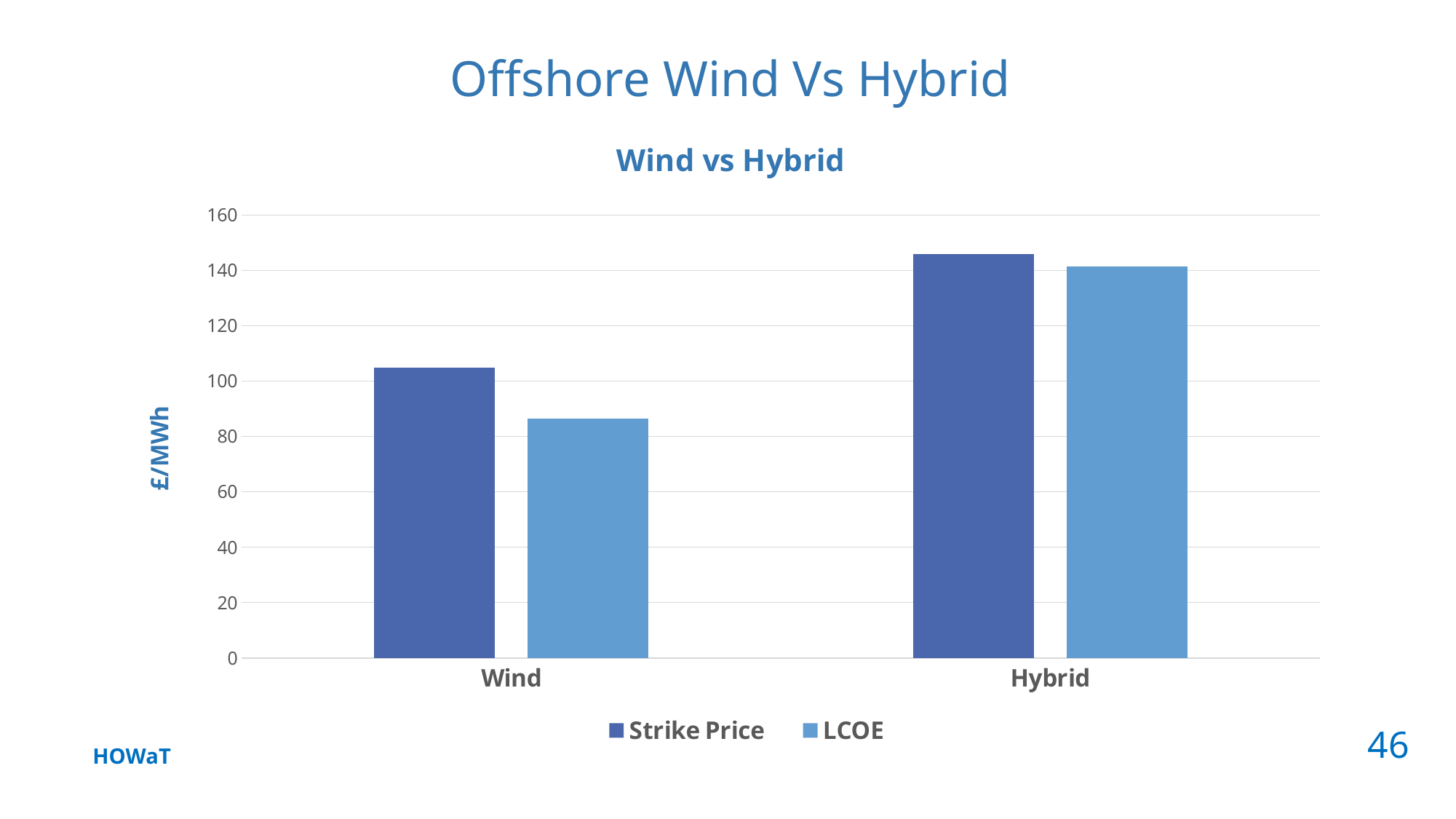
Is the LCOE value for Wind greater or less than 80? greater What is the label on the vertical axis? £/MWh What is the title of the chart? Wind vs Hybrid How many categories are shown on the x axis? 2 Is the LCOE value for Hybrid greater or less than 120? greater Is the LCOE value for Wind greater or less than 100? less Which category has the highest Strike Price? Hybrid For Wind, which is larger, the Strike Price or the LCOE? Strike Price What kind of chart is shown on the slide? bar chart How many series does the legend list? 2